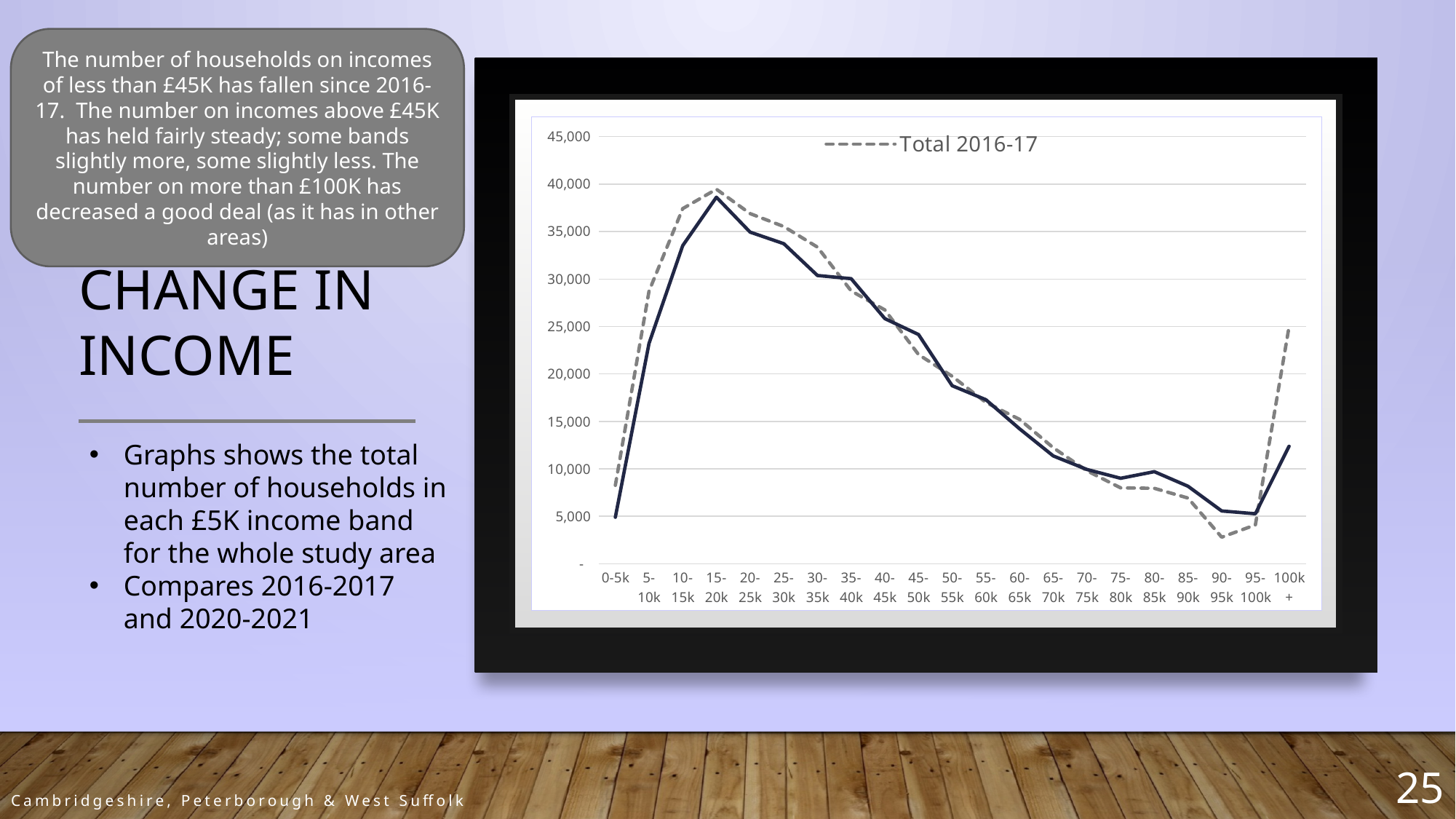
What is the name of the series shown in the chart's legend? Total 2016-17 Is the solid dark line's value for the 100k+ band greater or less than 10,000? greater Is the Total 2016-17 value for the 15-20k band greater or less than 35,000? greater Does the Total 2016-17 series rise or fall between the 15-20k band and the 90-95k band? fall Which income band has the highest value for the Total 2016-17 series? 15-20k What kind of chart is shown on the slide? line chart How many series does the chart's legend list? 1 Which income band has the lowest value for the Total 2016-17 series? 90-95k How many income bands are shown on the x axis of the chart? 21 Is the Total 2016-17 value for the 100k+ band greater or less than 20,000? greater At the 100k+ band, which line is higher: the dashed Total 2016-17 line or the solid dark line? the dashed Total 2016-17 line